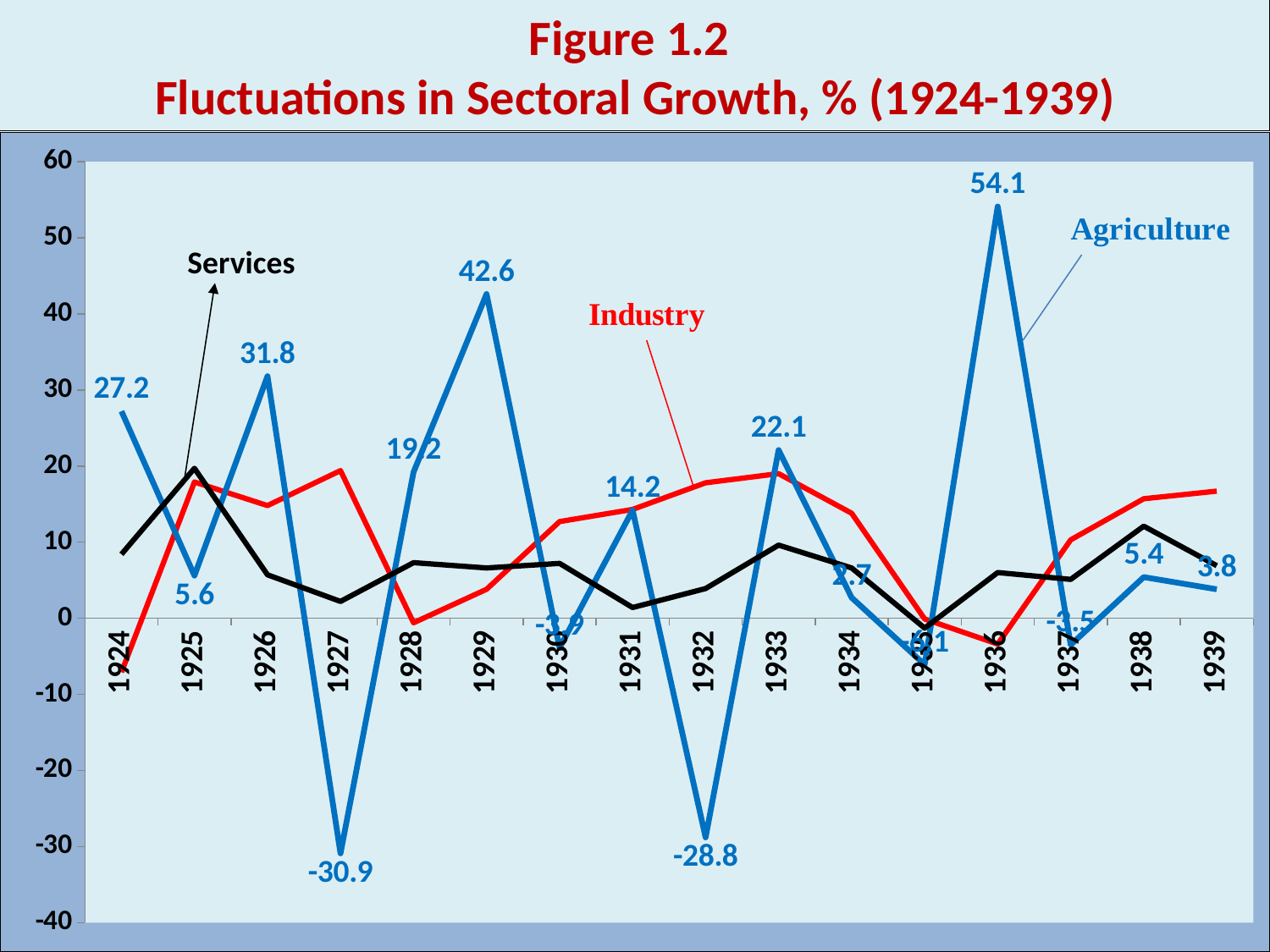
In which year does the Agriculture series reach its highest value? 1936 How many series are shown in the chart? 3 What is the Agriculture growth value for 1929? 42.6 How many years are plotted along the x axis? 16 What is the Agriculture growth value for 1927? -30.9 In which year does the Agriculture series reach its lowest value? 1927 Which is larger, the Agriculture value for 1926 or for 1933? 1926 What is the Agriculture growth value for 1932? -28.8 What is the Agriculture growth value for 1936? 54.1 What is the difference between the Agriculture values for 1936 and 1929? 11.5 What type of chart is shown on the slide? line chart Is the Industry value for 1927 greater or less than 10? greater